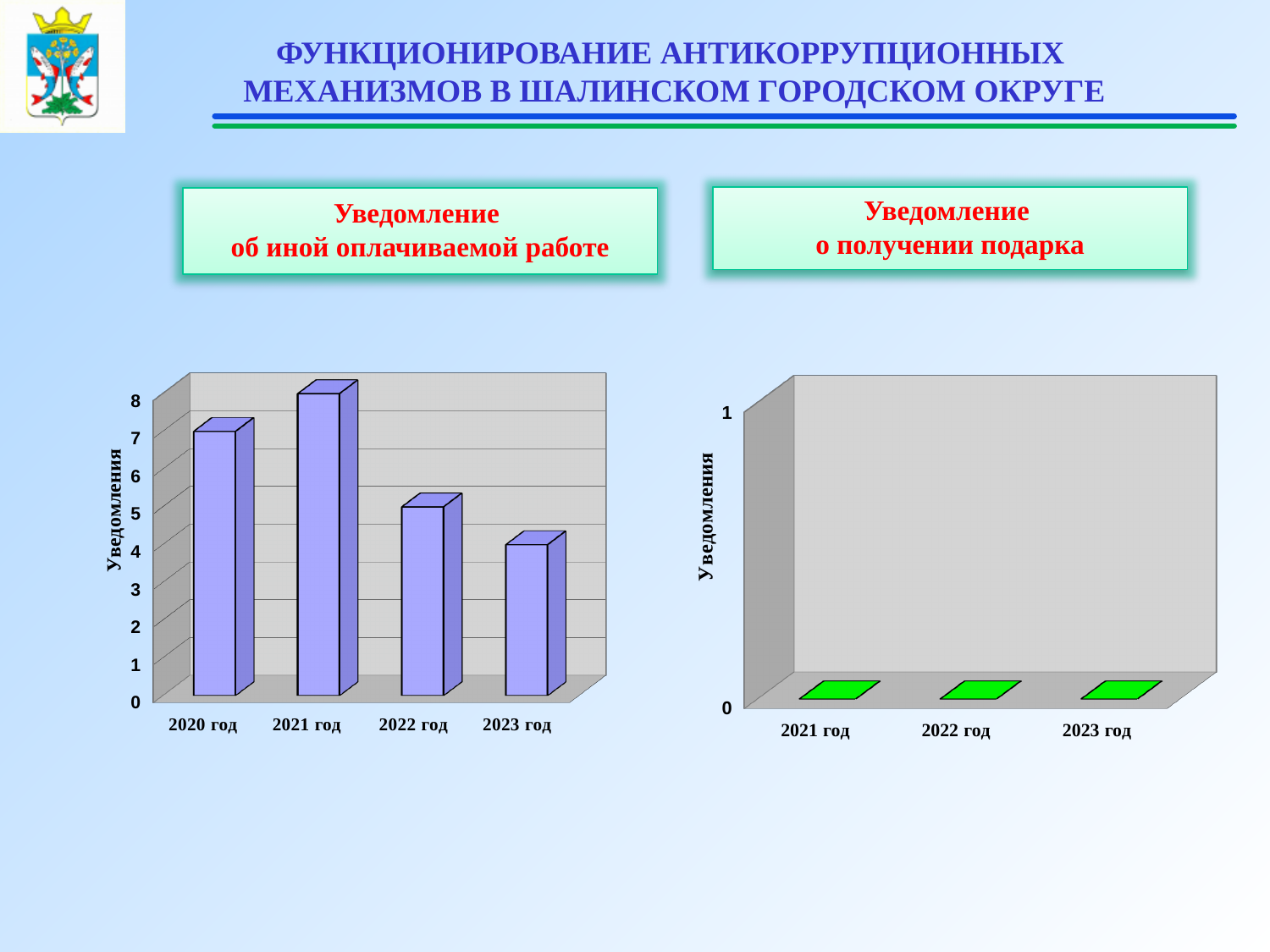
How many years are shown in the chart titled "Уведомление о получении подарка"? 3 How many years are shown in the chart titled "Уведомление об иной оплачиваемой работе"? 4 In the chart titled "Уведомление об иной оплачиваемой работе", which is larger, the value for 2020 год or the value for 2022 год? 2020 год In the chart titled "Уведомление об иной оплачиваемой работе", which year has the lowest value? 2023 год What kind of chart is the chart titled "Уведомление об иной оплачиваемой работе"? bar chart In the chart titled "Уведомление об иной оплачиваемой работе", which year has the highest value? 2021 год In the chart titled "Уведомление об иной оплачиваемой работе", do the values rise or fall from 2021 год to 2023 год? fall In the chart titled "Уведомление об иной оплачиваемой работе", what is the value for 2023 год? 4 In the chart titled "Уведомление об иной оплачиваемой работе", is the value for 2022 год greater or less than 6? less In the chart titled "Уведомление об иной оплачиваемой работе", what is the difference between the values for 2020 год and 2022 год? 2 In the chart titled "Уведомление о получении подарка", what is the value for 2022 год? 0 In the chart titled "Уведомление об иной оплачиваемой работе", what is the value for 2021 год? 8